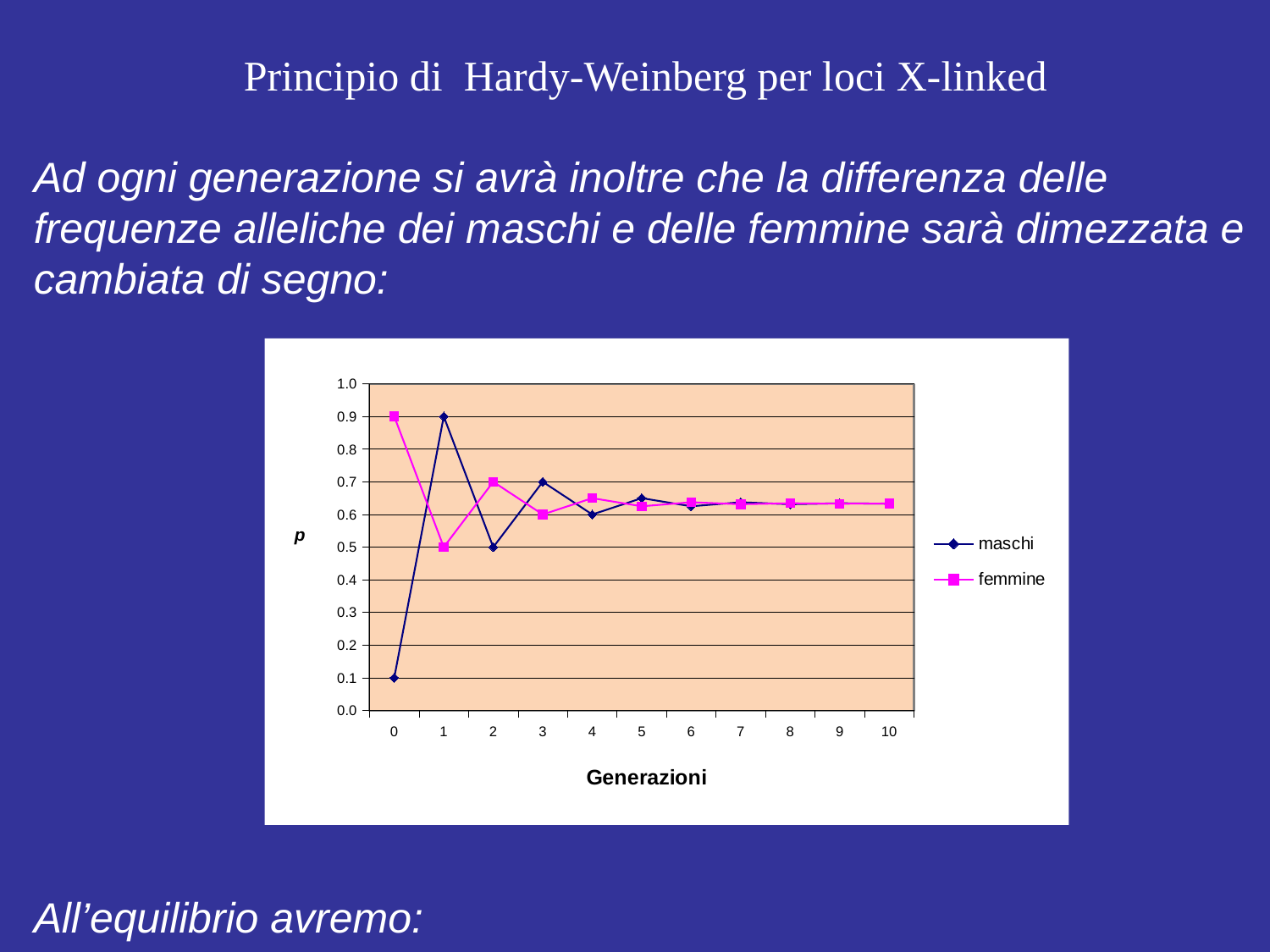
How many generations are plotted along the x axis? 11 What is the value of p for maschi at generation 0? 0.1 Is the value for femmine at generation 4 greater or less than 0.6? greater What is the difference between the maschi value at generation 1 and at generation 0? 0.8 What is the value of p for femmine at generation 2? 0.7 At generation 1, which series has the larger value, maschi or femmine? maschi At which generation does the maschi series reach its lowest value? 0 What kind of chart is shown on the slide? line chart At which generation does the maschi series reach its highest value? 1 What is the value of p for femmine at generation 0? 0.9 How many series does the legend list? 2 What is the value of p for maschi at generation 1? 0.9